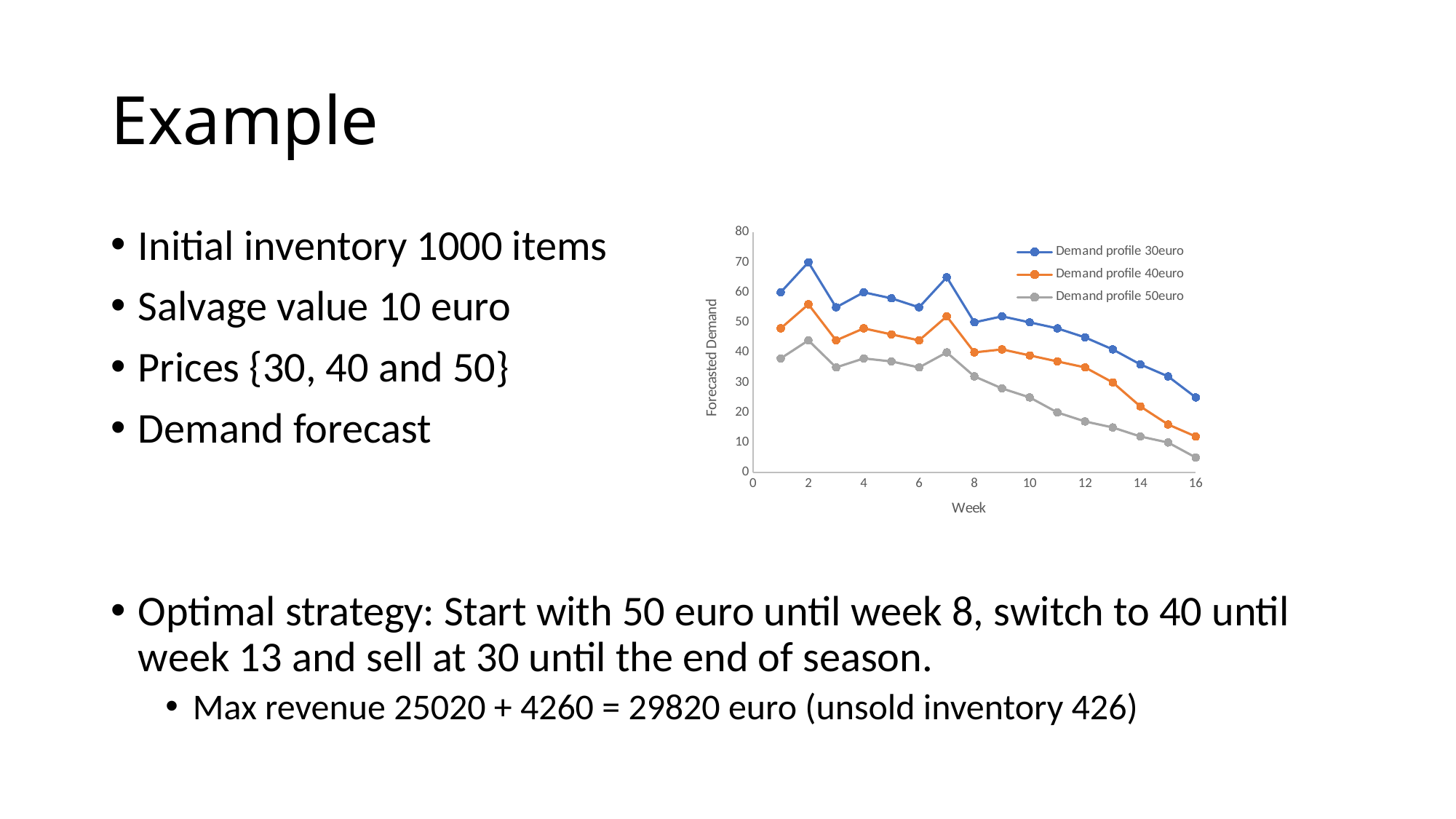
Is the value for Demand profile 30euro at week 16 greater or less than 30? less Which series has the lowest forecasted demand across the weeks? Demand profile 50euro What kind of chart is shown on the slide? line chart How many series does the chart legend list? 3 How many weekly data points are plotted for the Demand profile 30euro series? 16 Is the value for Demand profile 50euro at week 16 greater or less than 10? less Which series has the highest forecasted demand across the weeks? Demand profile 30euro In which week does the Demand profile 50euro series reach its lowest value? Week 16 At week 8, which is larger: Demand profile 30euro or Demand profile 50euro? Demand profile 30euro Overall, do the forecasted demand values rise or fall from week 8 to week 16? fall In which week does the Demand profile 30euro series reach its highest value? Week 2 Is the value for Demand profile 30euro at week 2 greater or less than 60? greater